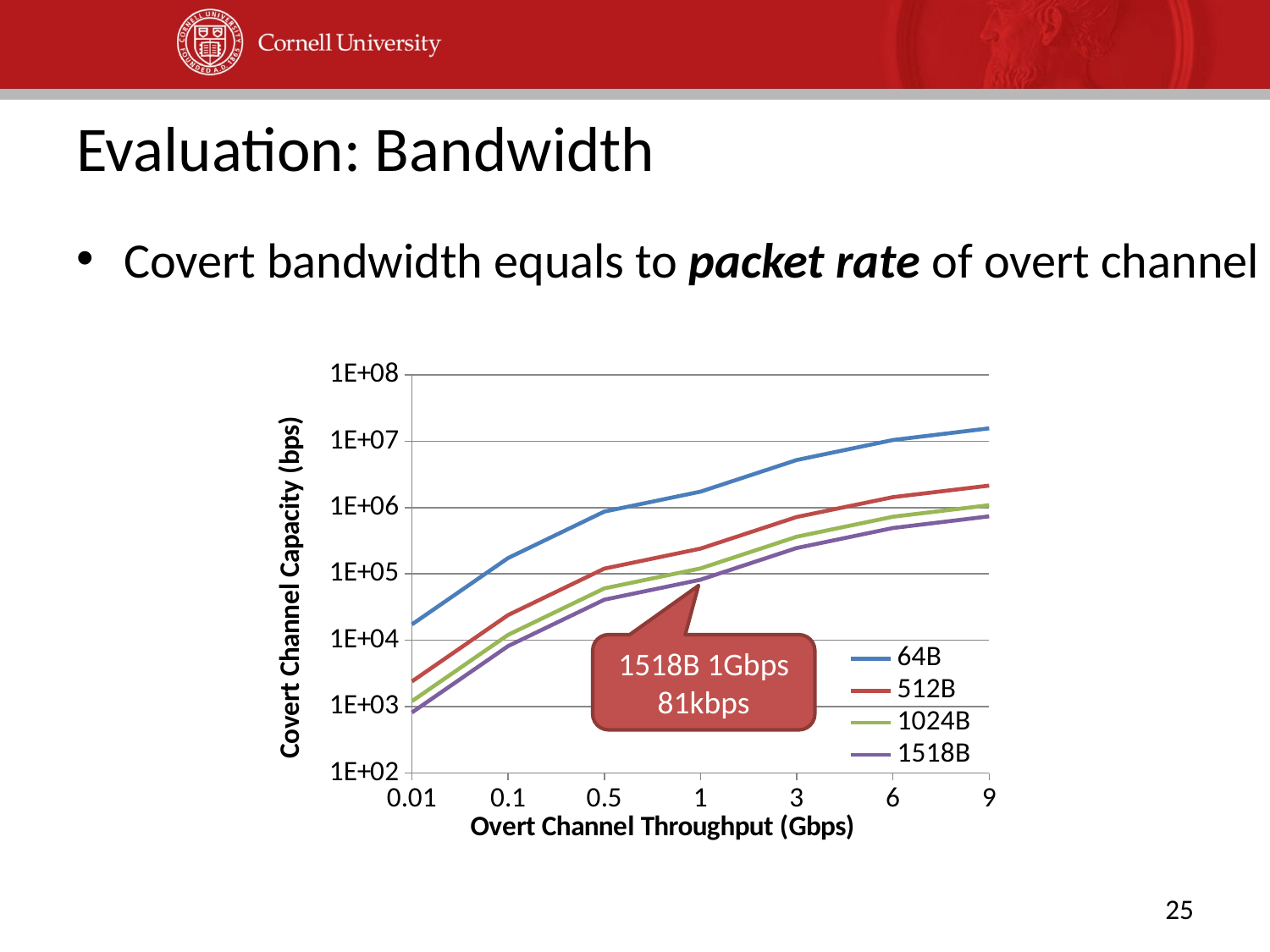
Is the covert channel capacity for 512B at 9 Gbps greater or less than 1E+06 bps? greater According to the callout on the chart, what is the covert channel capacity for 1518B packets at 1 Gbps? 81kbps What kind of chart is shown on the slide? line chart Is the covert channel capacity for 1518B at 3 Gbps greater or less than 1E+05 bps? greater Which packet size series has the lowest covert channel capacity across the chart? 1518B How many throughput values are marked on the x axis? 7 Is the covert channel capacity for 64B at 9 Gbps greater or less than 1E+07 bps? greater At 9 Gbps, which series has the larger covert channel capacity, 64B or 1518B? 64B What is the title of the y axis of the chart? Covert Channel Capacity (bps) How many series does the legend list? 4 Do the covert channel capacity values rise or fall as overt channel throughput increases? rise Which packet size series has the highest covert channel capacity across the chart? 64B